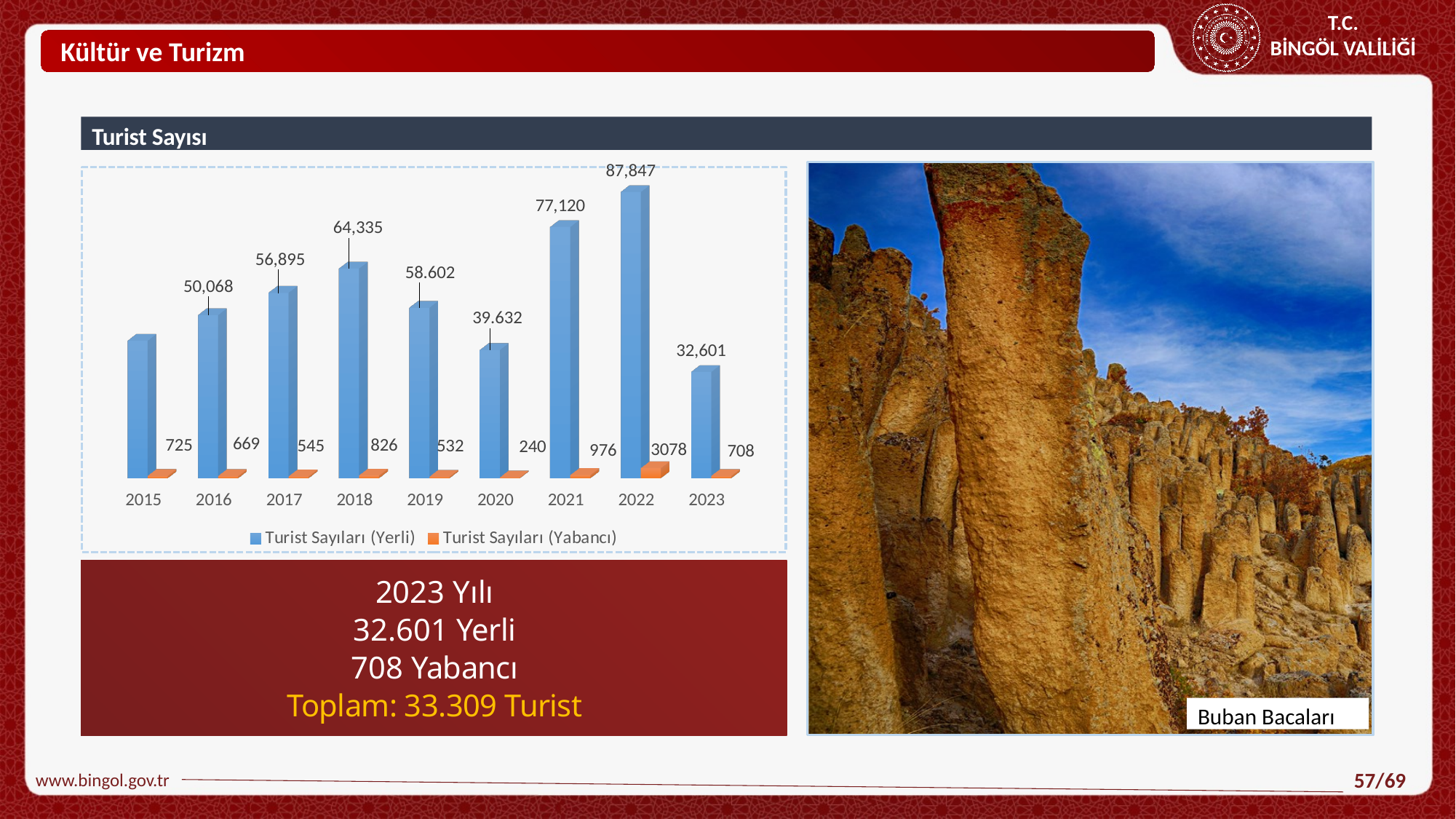
What is the difference between the Turist Sayıları (Yerli) values for 2022 and 2021? 10,727 What is the value for Turist Sayıları (Yabancı) in 2020? 240 How many series does the chart legend list? 2 Which year has the lowest value for Turist Sayıları (Yabancı)? 2020 What is the value for Turist Sayıları (Yerli) in 2018? 64,335 Do the Turist Sayıları (Yerli) values rise or fall from 2020 to 2022? Rise Which year has the highest value for Turist Sayıları (Yerli)? 2022 Which year has the highest value for Turist Sayıları (Yabancı)? 2022 What kind of chart is shown on the slide? Bar chart Which is larger, the Turist Sayıları (Yerli) value for 2017 or for 2018? 2018 How many years are shown on the x axis of the chart? 9 What is the value for Turist Sayıları (Yerli) in 2022? 87,847